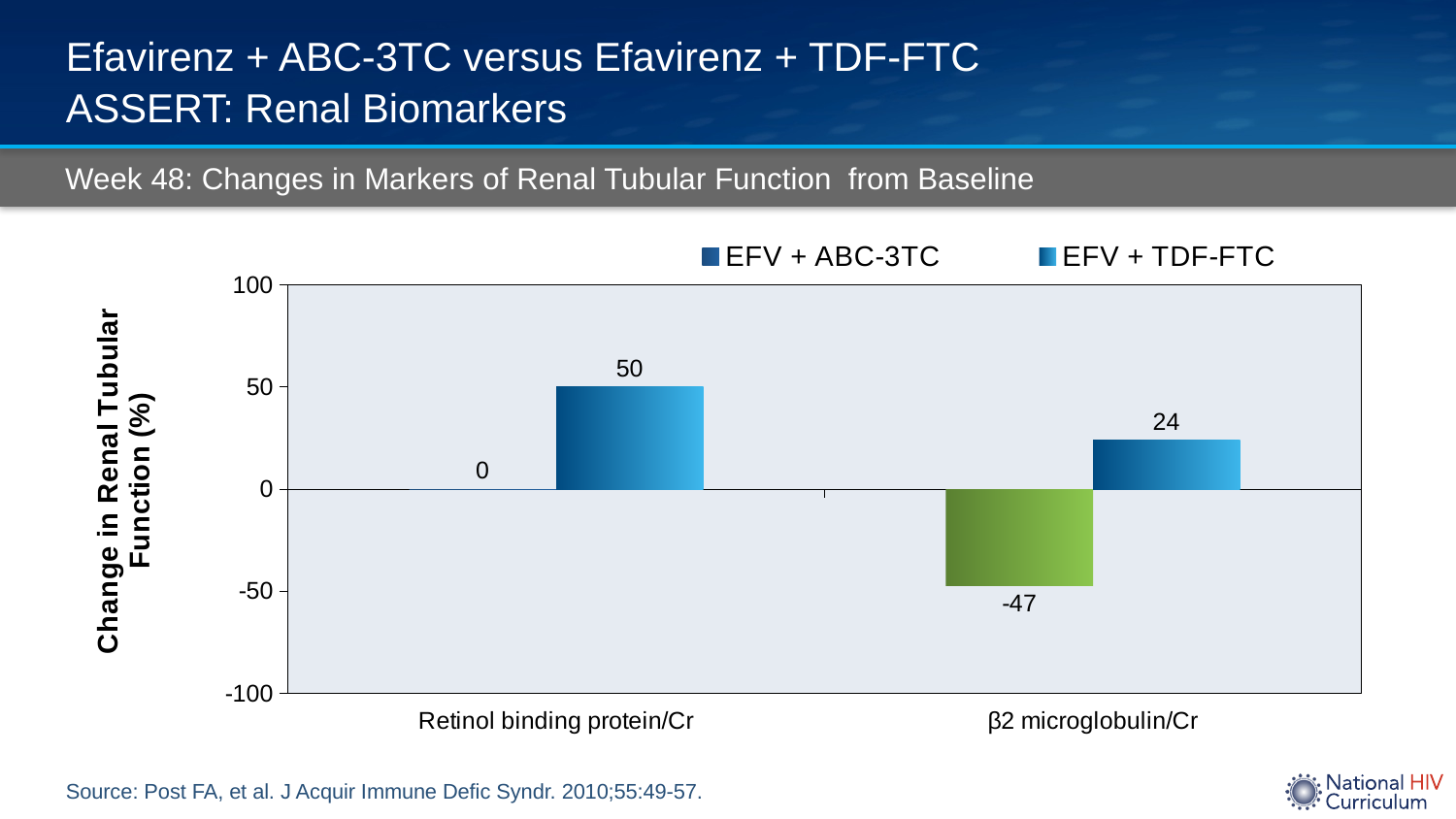
What is the difference between the EFV + TDF-FTC values for Retinol binding protein/Cr and β2 microglobulin/Cr? 26 What is the value for EFV + ABC-3TC for Retinol binding protein/Cr? 0 Which category has the highest value for EFV + TDF-FTC? Retinol binding protein/Cr How many series does the legend list? 2 What is the value for EFV + TDF-FTC for Retinol binding protein/Cr? 50 What is the value for EFV + TDF-FTC for β2 microglobulin/Cr? 24 What is the label of the y axis? Change in Renal Tubular Function (%) How many categories are shown on the x axis? 2 What is the value for EFV + ABC-3TC for β2 microglobulin/Cr? -47 Which category has the lowest value for EFV + ABC-3TC? β2 microglobulin/Cr What kind of chart is shown on the slide? Bar chart For β2 microglobulin/Cr, which series has the larger value, EFV + ABC-3TC or EFV + TDF-FTC? EFV + TDF-FTC